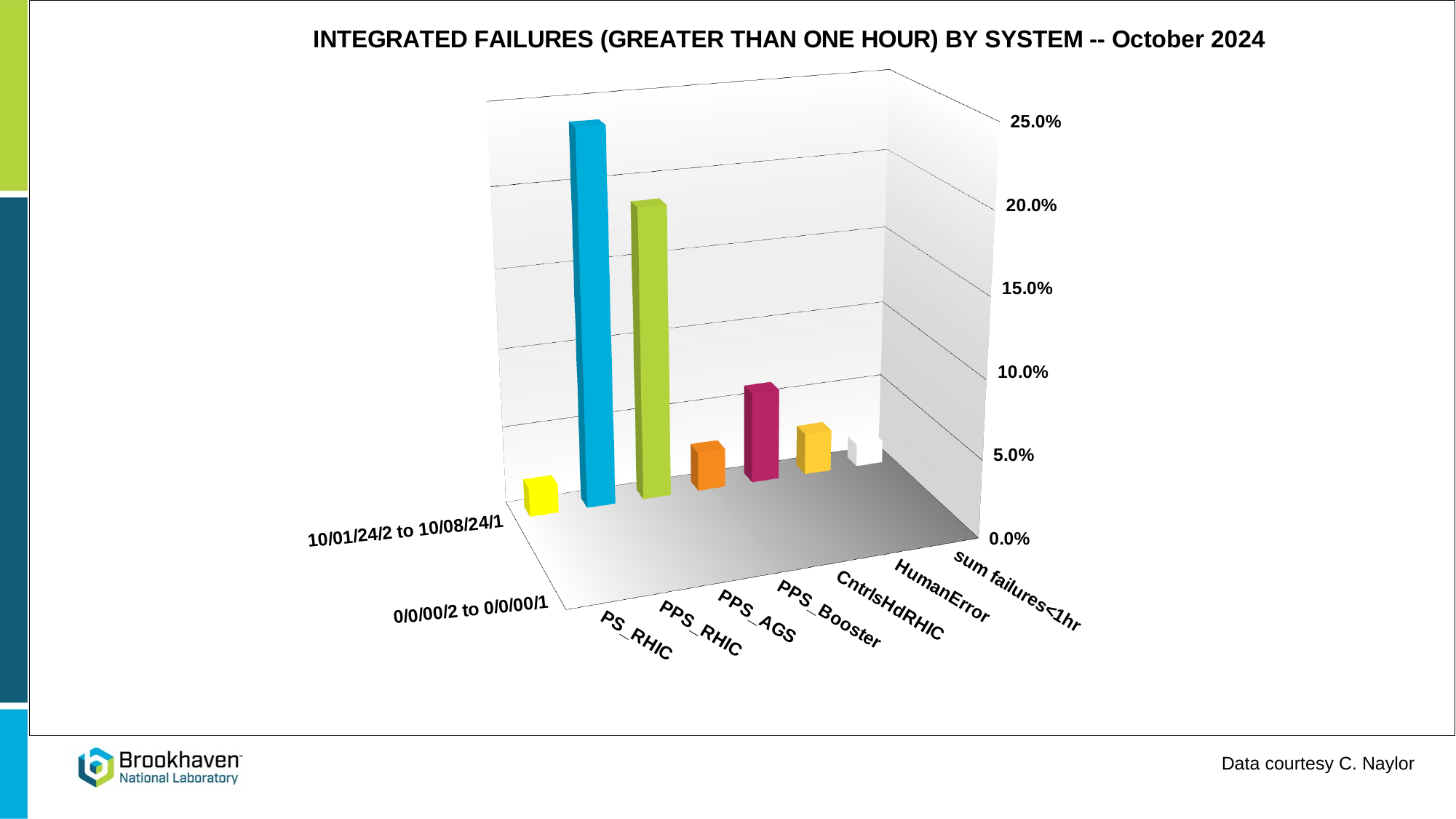
Which is larger, the value for CntrlsHdRHIC or the value for PPS_Booster? CntrlsHdRHIC What kind of chart is shown on the slide? bar chart Which system has the highest value? PPS_RHIC Is the value for PPS_AGS greater or less than 15.0%? greater Is the value for PPS_RHIC greater or less than 20.0%? greater Which is larger, the value for PPS_AGS or the value for CntrlsHdRHIC? PPS_AGS Is the value for CntrlsHdRHIC greater or less than 10.0%? less What colour is the bar for PPS_RHIC? blue Which is larger, the value for PPS_RHIC or the value for PPS_AGS? PPS_RHIC How many system categories are shown along the x axis? 7 What is the title of the chart? INTEGRATED FAILURES (GREATER THAN ONE HOUR) BY SYSTEM -- October 2024